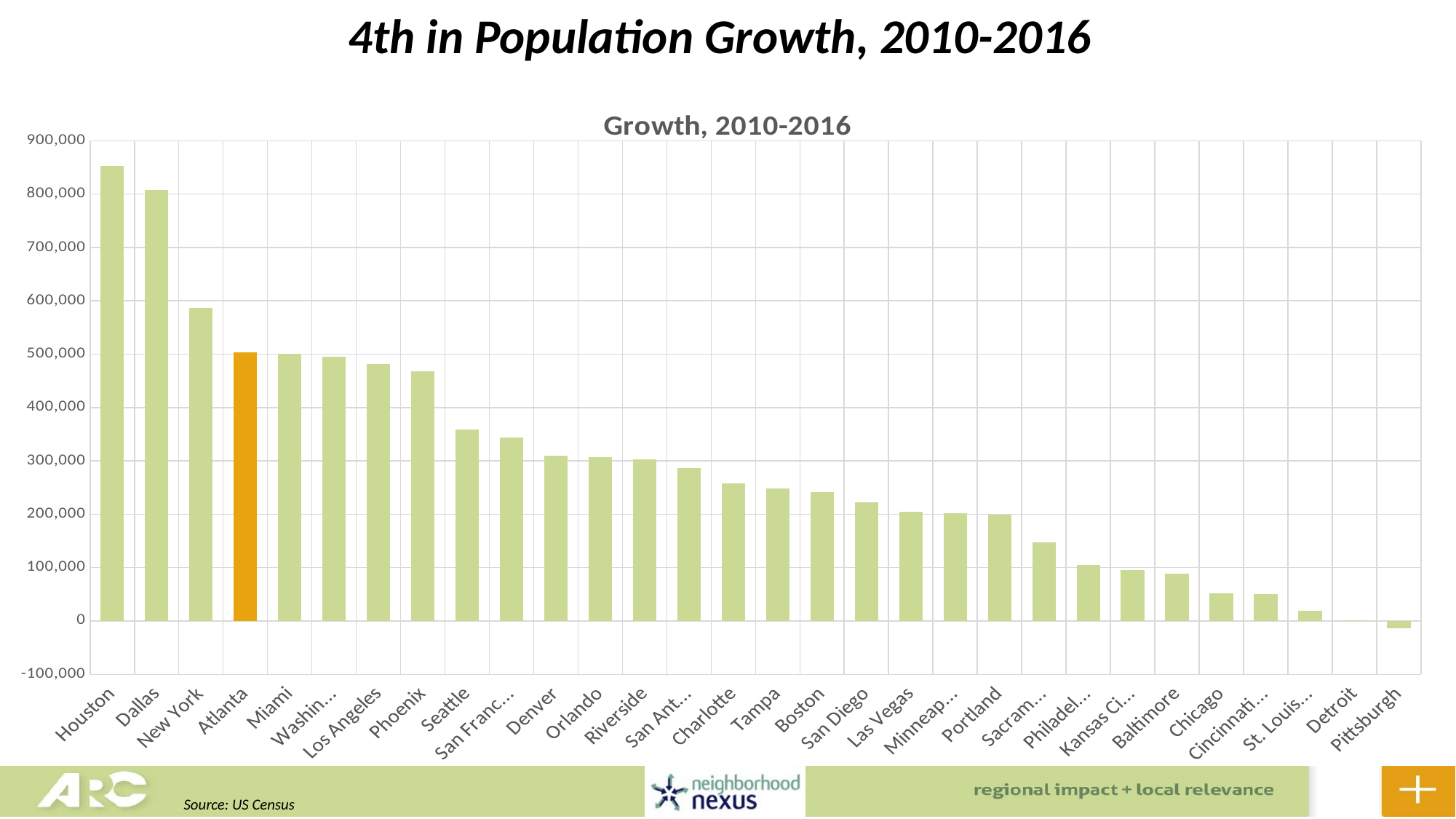
Is the value for Chicago greater or less than 100,000? less Which has a larger population growth, Phoenix or Denver? Phoenix Do the bar values rise or fall from left to right across the chart? fall Is the value for Seattle greater or less than 400,000? less Is the value for New York greater or less than 600,000? less What kind of chart is shown on the slide? bar chart How many metro areas are shown in the chart? 30 Which metro area has the lowest population growth, 2010-2016? Pittsburgh Which has a larger population growth, Dallas or New York? Dallas Which metro area's bar is highlighted in orange? Atlanta Which metro area has the highest population growth, 2010-2016? Houston